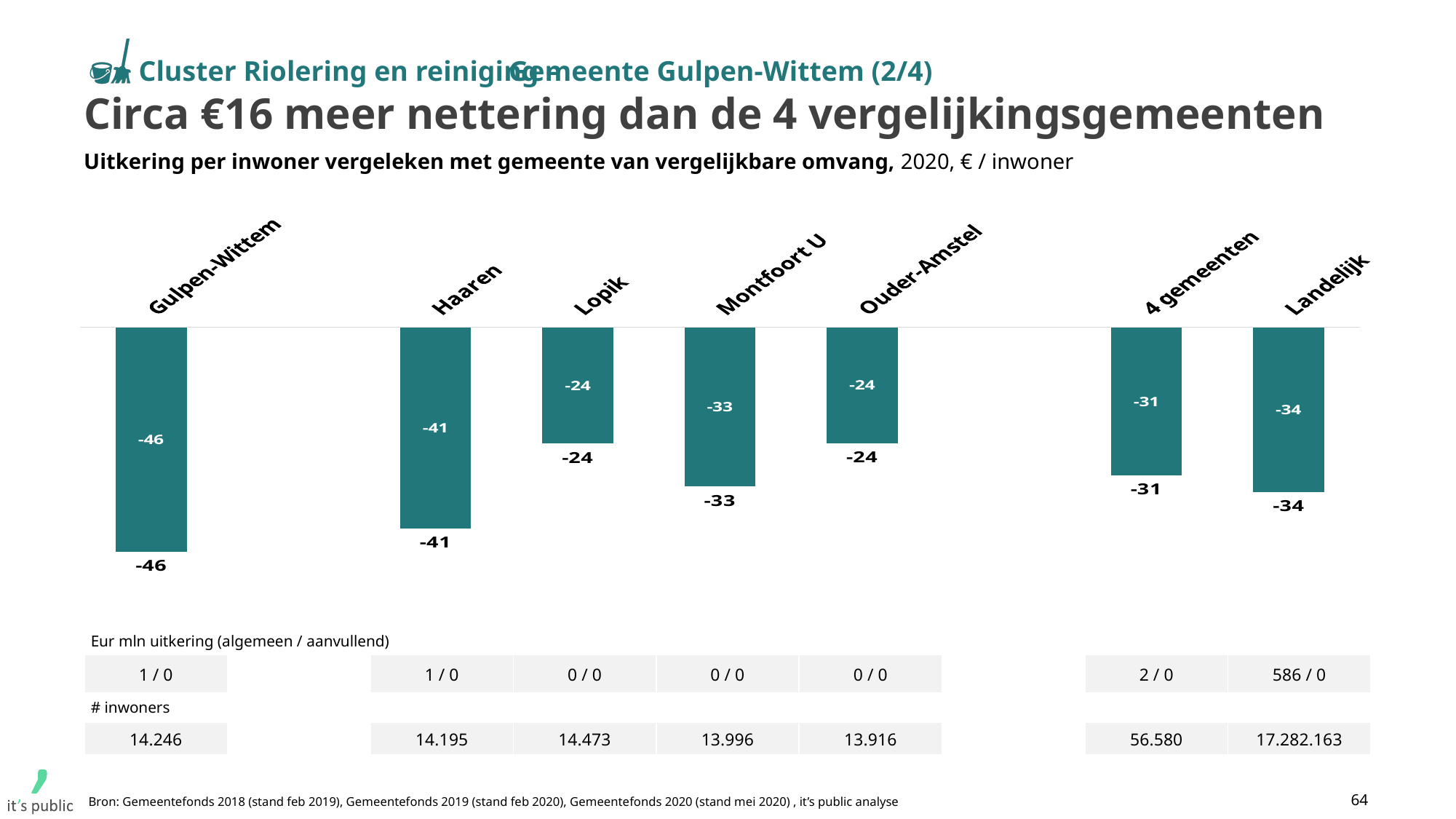
What is the difference between the values for Haaren and Landelijk? 7 Which category has the lowest (most negative) value? Gulpen-Wittem What is the value for Landelijk? -34 Which has the lower value, Haaren or Montfoort U? Haaren What is the value for Gulpen-Wittem? -46 What unit is stated in the chart subtitle? € / inwoner What kind of chart is shown on the slide? Bar chart How many categories are shown in the chart? 7 What is the difference between the values for Montfoort U and Lopik? 9 What is the value for Haaren? -41 What is the value for 4 gemeenten? -31 What is the value for Montfoort U? -33